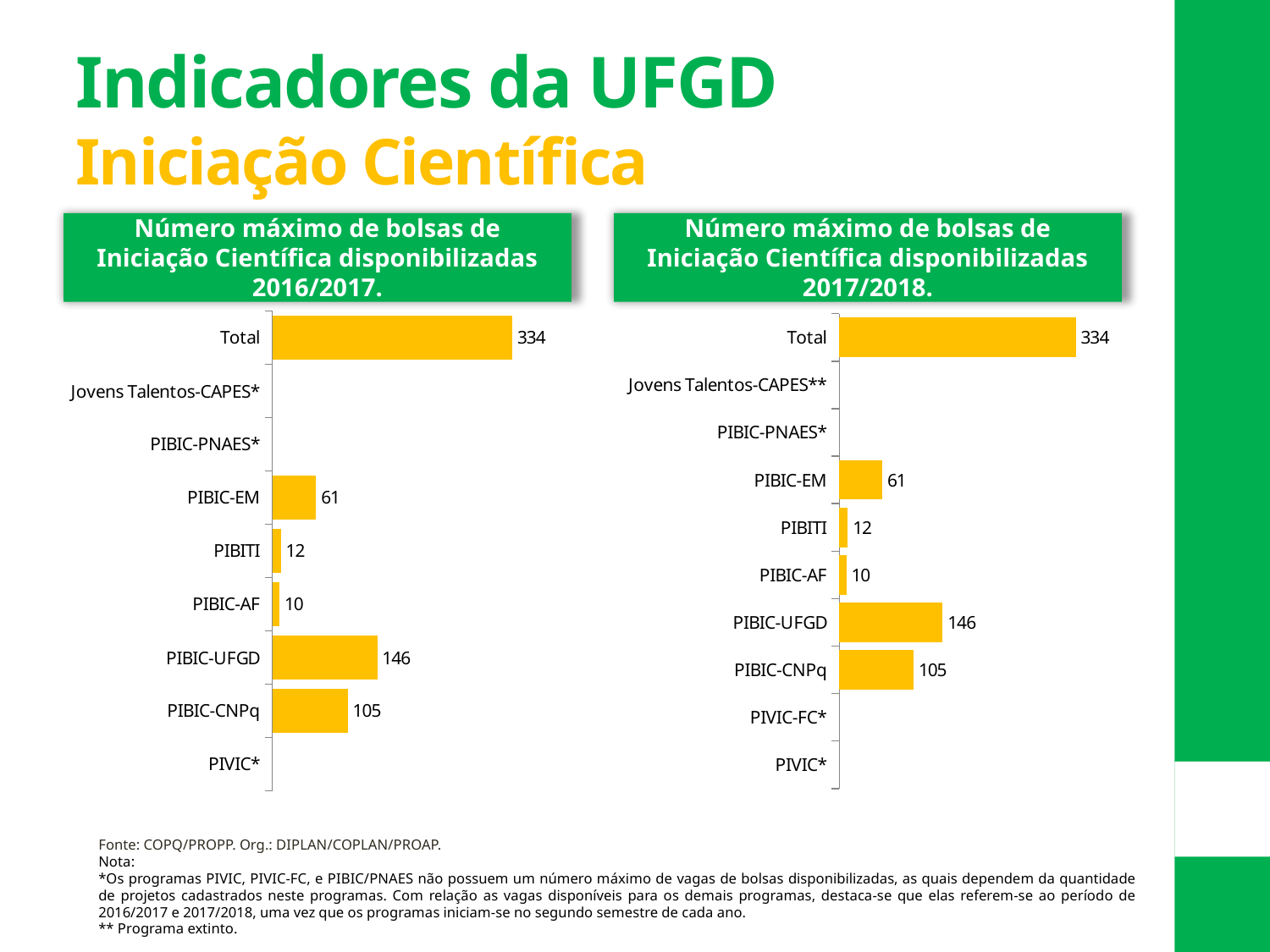
In the right chart (2017/2018), which is larger: PIBIC-EM or PIBITI? PIBIC-EM In the right chart (2017/2018), which program with a plotted bar has the lowest value? PIBIC-AF In the left chart (2016/2017), excluding Total, which program has the highest number of scholarships? PIBIC-UFGD What type of chart is used on the left (2016/2017)? Bar chart In the right chart (2017/2018), what is the value for PIBIC-AF? 10 How many category labels are listed on the right chart (2017/2018)? 10 In the left chart (2016/2017), what is the difference between PIBIC-UFGD and PIBIC-CNPq? 41 In the right chart (2017/2018), what is the value for PIBIC-CNPq? 105 In the left chart (2016/2017), what is the Total value? 334 In the left chart (2016/2017), what is the value for PIBIC-EM? 61 In the left chart (2016/2017), what is the value for PIBIC-UFGD? 146 What colour are the bars in both charts? Yellow